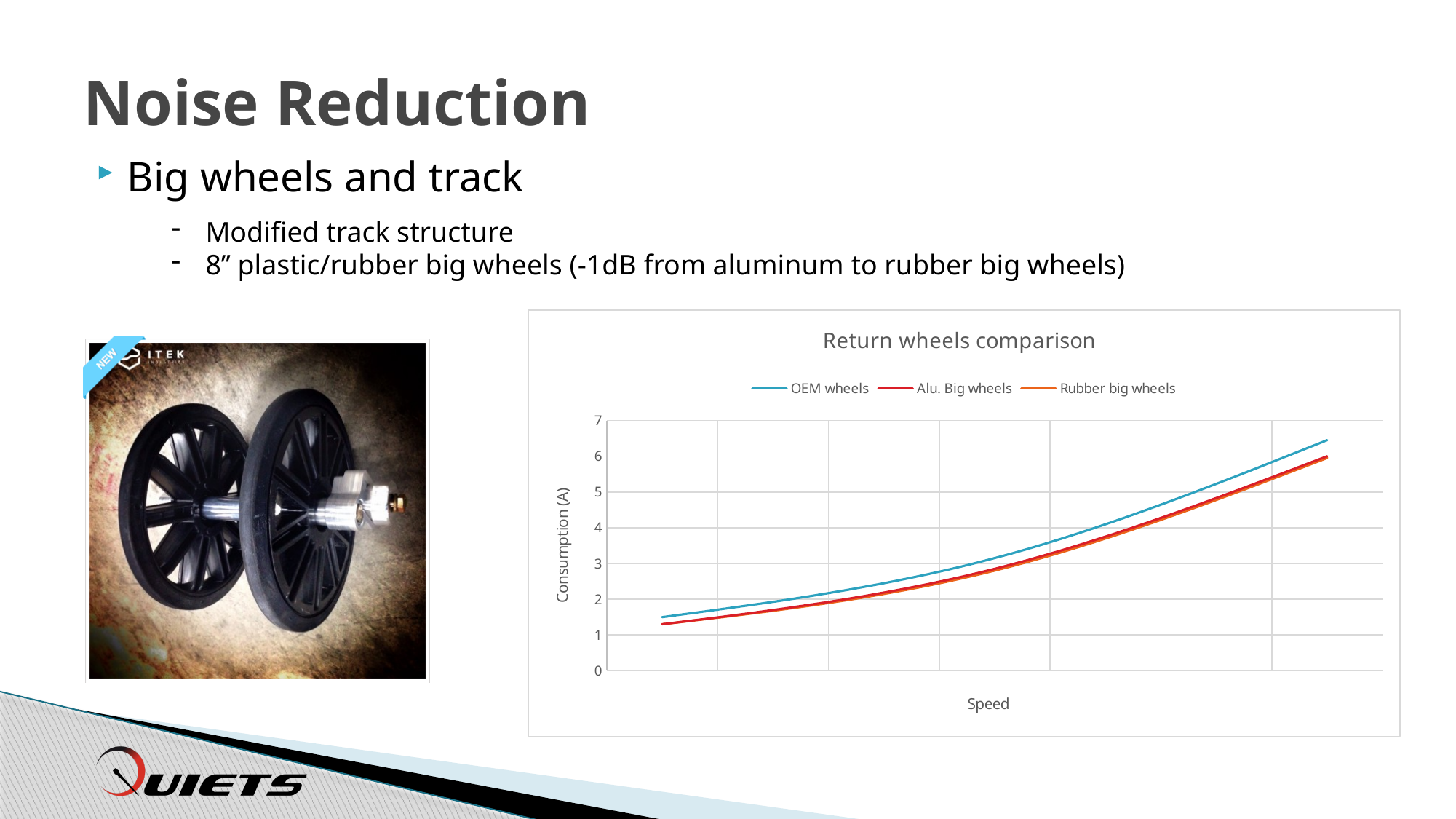
At the right end of the chart, is the value for OEM wheels greater or less than 6? greater At the left end of the chart, is the value for Alu. Big wheels greater or less than 2? less What is the title of the chart? Return wheels comparison What is the label of the vertical axis of the chart? Consumption (A) Do the values of the Rubber big wheels series rise or fall along the x axis? rise At the right end of the chart, which is larger: the value for OEM wheels or the value for Alu. Big wheels? OEM wheels How many series does the legend of the chart list? 3 Do the values of the OEM wheels series rise or fall as speed increases along the x axis? rise Which series has the highest consumption at the right end of the chart? OEM wheels At the left end of the chart, is the value for OEM wheels greater or less than 2? less What kind of chart is shown on the slide? line chart